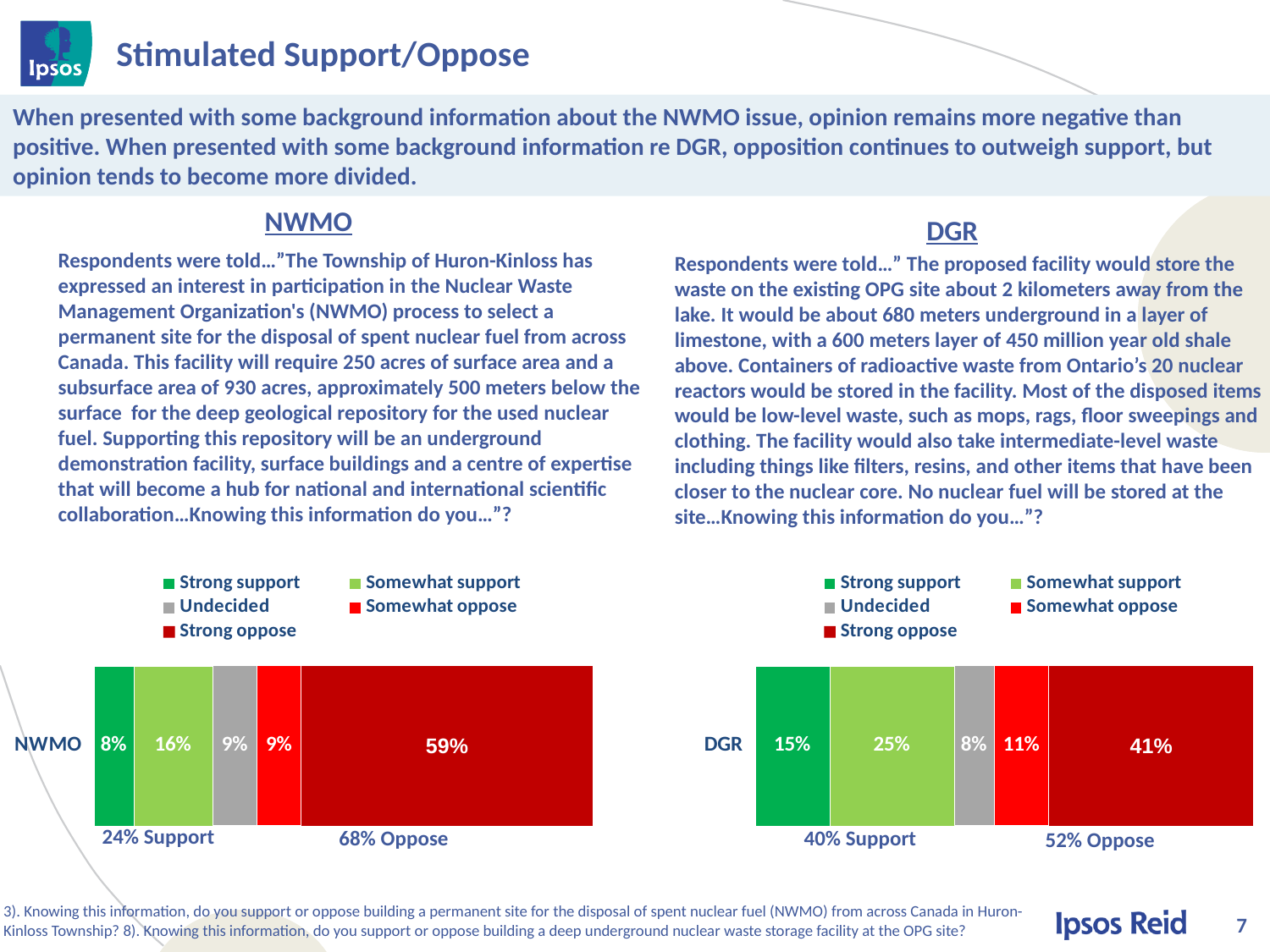
In the NWMO chart, which response category has the smallest share? Strong support In the DGR chart, which response category has the largest share? Strong oppose In the NWMO chart, what percentage of respondents were undecided? 9% In the DGR chart, which response category has the smallest share? Undecided How many series does the legend of the NWMO chart list? 5 In the DGR chart, what is the total of all segments in the stacked bar? 100% In the NWMO chart, what percentage of respondents said they strongly oppose? 59% In the DGR chart, what percentage of respondents said they strongly support? 15% Which is larger: somewhat support in the NWMO chart or somewhat support in the DGR chart? DGR What type of chart is used for the DGR results? Stacked bar chart In the DGR chart, what percentage of respondents said they somewhat support? 25% What is the difference between the strong oppose percentages in the NWMO chart and the DGR chart? 18 percentage points